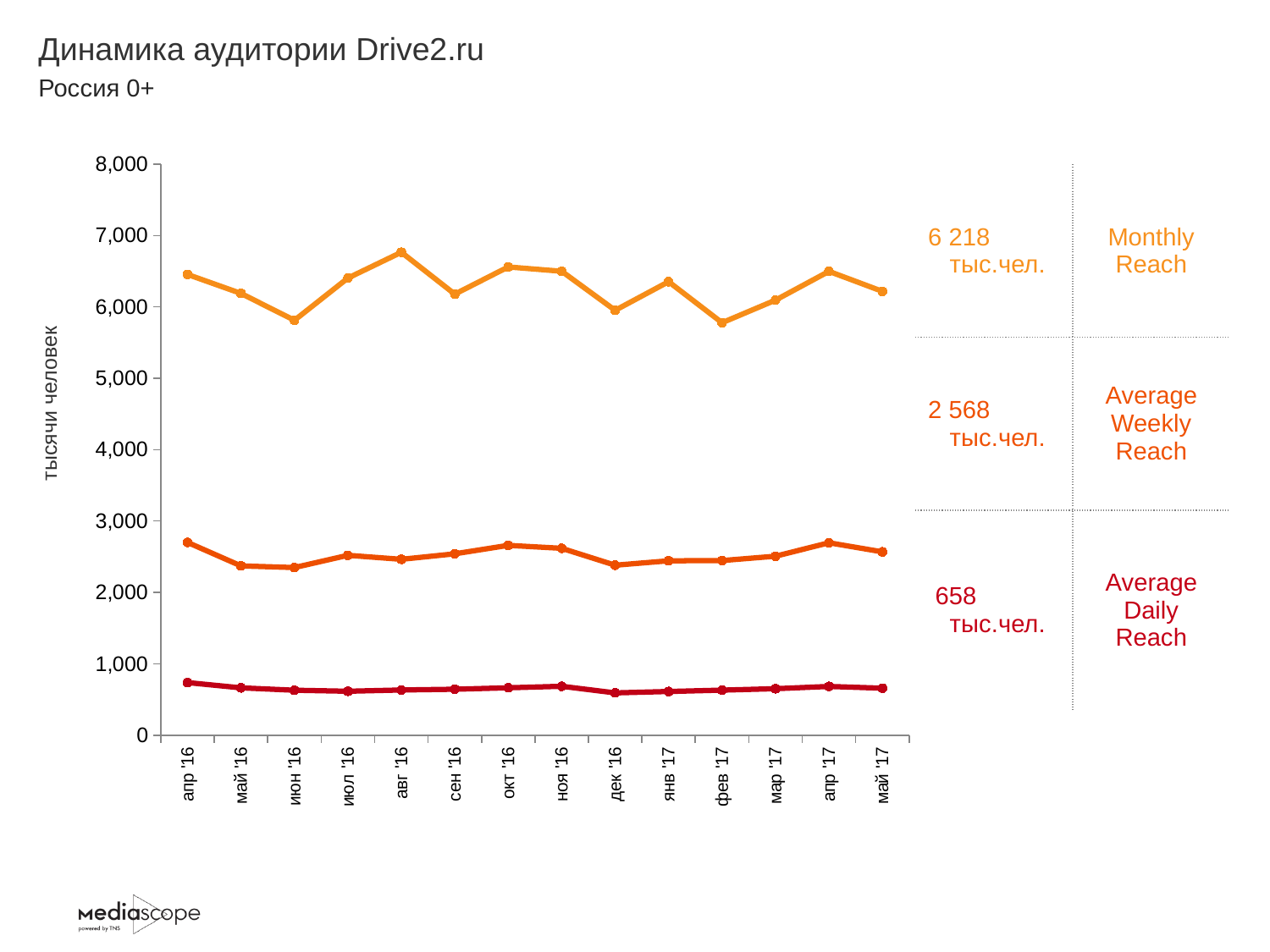
What is the label on the y axis of the chart? тысячи человек Which month has the larger Monthly Reach, авг '16 or дек '16? авг '16 Does the Monthly Reach line rise or fall from апр '16 to июн '16? fall What is the Average Weekly Reach value shown for май '17? 2 568 тыс.чел. Is the Average Daily Reach value for апр '16 greater or less than 1,000? less What is the Monthly Reach value shown for май '17? 6 218 тыс.чел. What is the Average Daily Reach value shown for май '17? 658 тыс.чел. How many months are plotted along the x axis? 14 What kind of chart is shown on the slide? line chart In which month is the Monthly Reach line at its highest? авг '16 Is the Monthly Reach value for июн '16 greater or less than 6,000? less How many lines (series) are plotted on the chart? 3